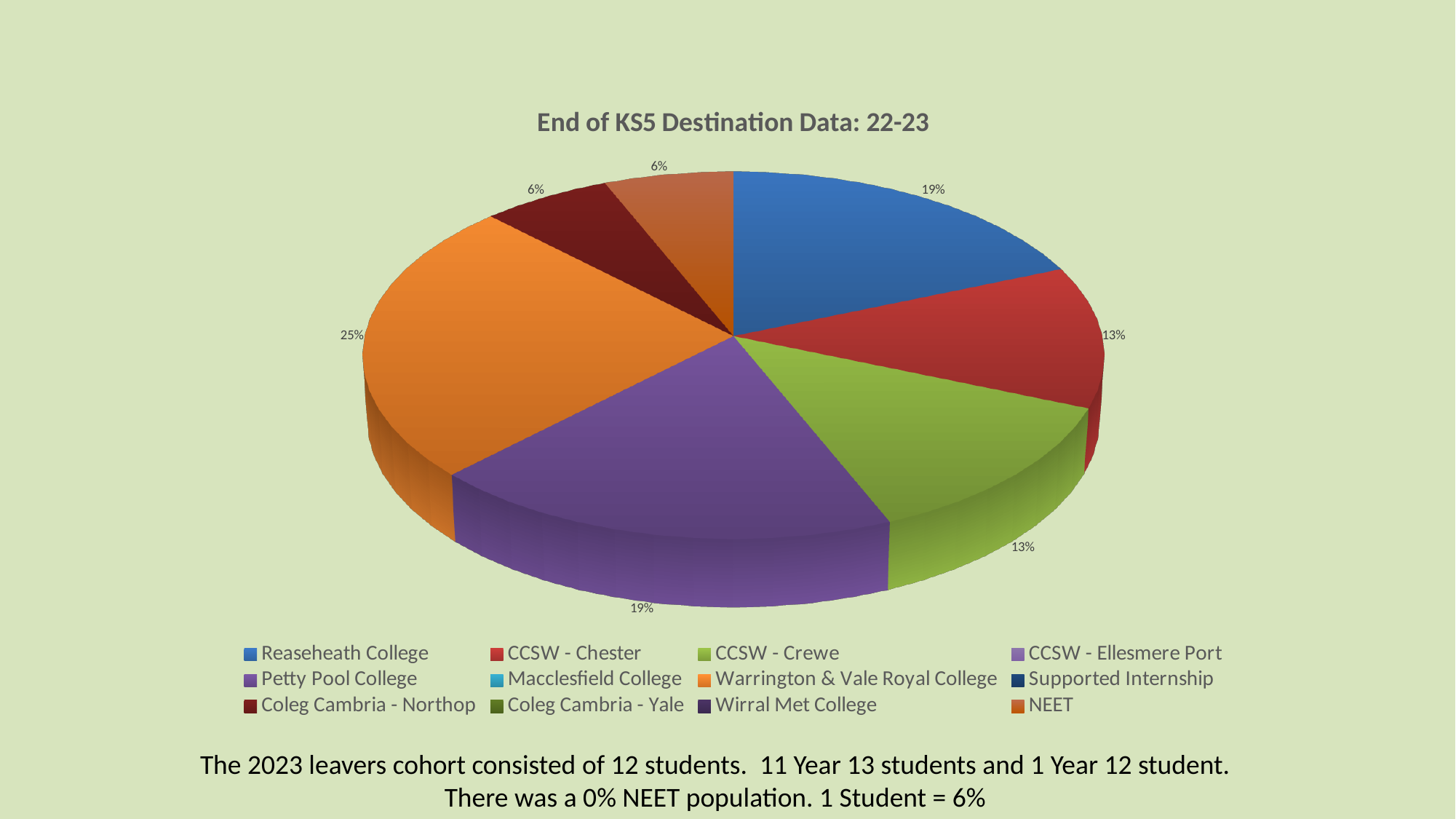
What is the title of the chart? End of KS5 Destination Data: 22-23 How many slices are shown in the pie chart? 7 What percentage of the pie does Coleg Cambria - Northop account for? 6% What percentage of the pie does CCSW - Crewe account for? 13% Which slice is larger, Reaseheath College or CCSW - Chester? Reaseheath College What percentage of the pie does Reaseheath College account for? 19% How many entries does the legend list? 12 Which destination has the largest slice of the pie? Warrington & Vale Royal College How many percentage points larger is the Warrington & Vale Royal College slice than the Reaseheath College slice? 6% What type of chart is shown on the slide? Pie chart